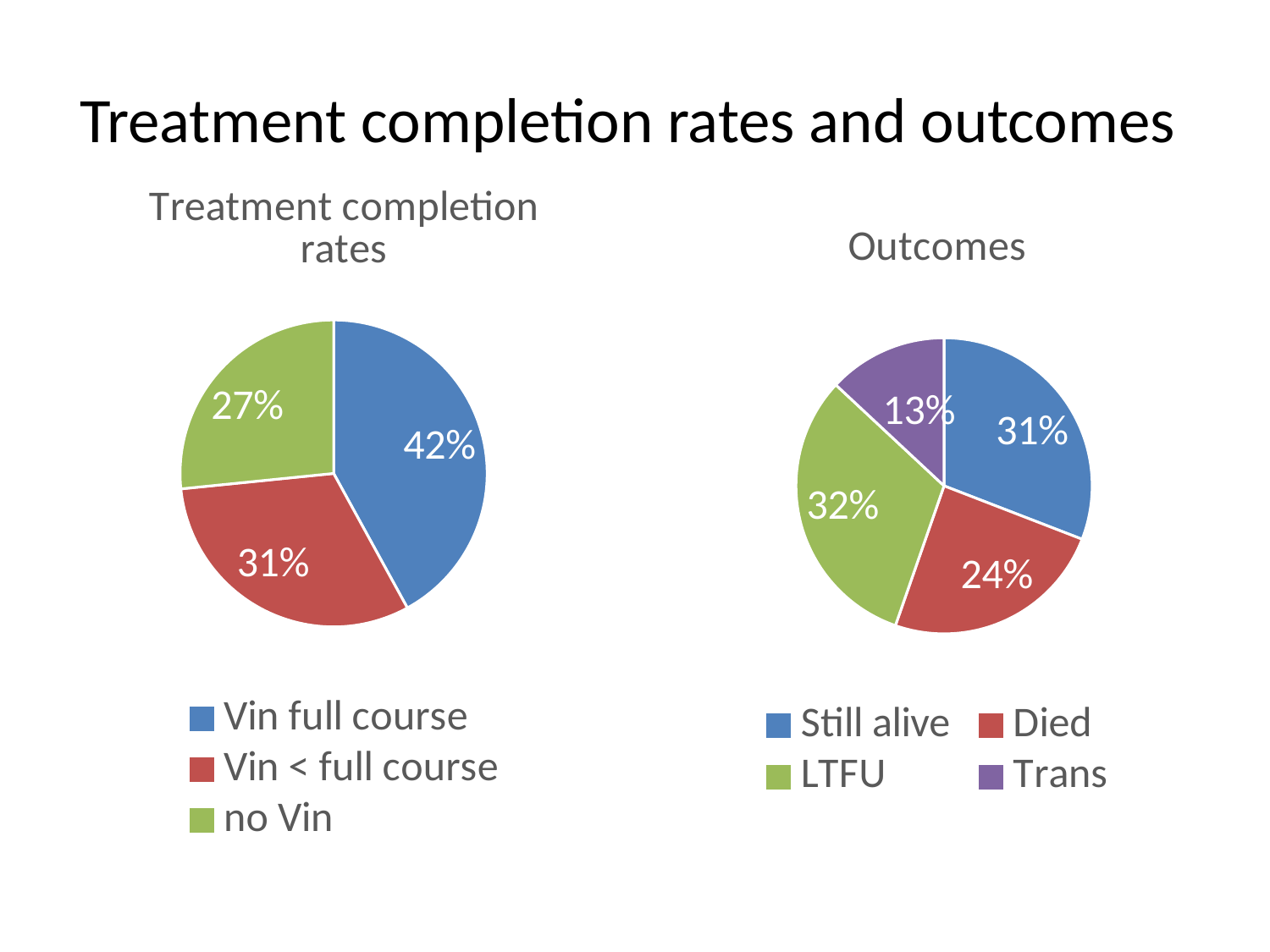
In the 'Treatment completion rates' chart, what share is labelled for 'Vin full course'? 42% In the 'Treatment completion rates' chart, which category has the largest slice? Vin full course In the 'Outcomes' chart, which is larger, 'Still alive' or 'Died'? Still alive In the 'Outcomes' chart, what share is labelled for 'Trans'? 13% How many categories does the legend of the 'Outcomes' chart list? 4 In the 'Treatment completion rates' chart, what share is labelled for 'no Vin'? 27% In the 'Outcomes' chart, which category has the smallest slice? Trans How many slices does the 'Treatment completion rates' chart have? 3 In the 'Outcomes' chart, what share is labelled for 'Died'? 24% In the 'Treatment completion rates' chart, which category has the smallest slice? no Vin What type of chart is the 'Outcomes' chart? Pie chart In the 'Treatment completion rates' chart, what is the difference in percentage points between 'Vin full course' and 'Vin < full course'? 11